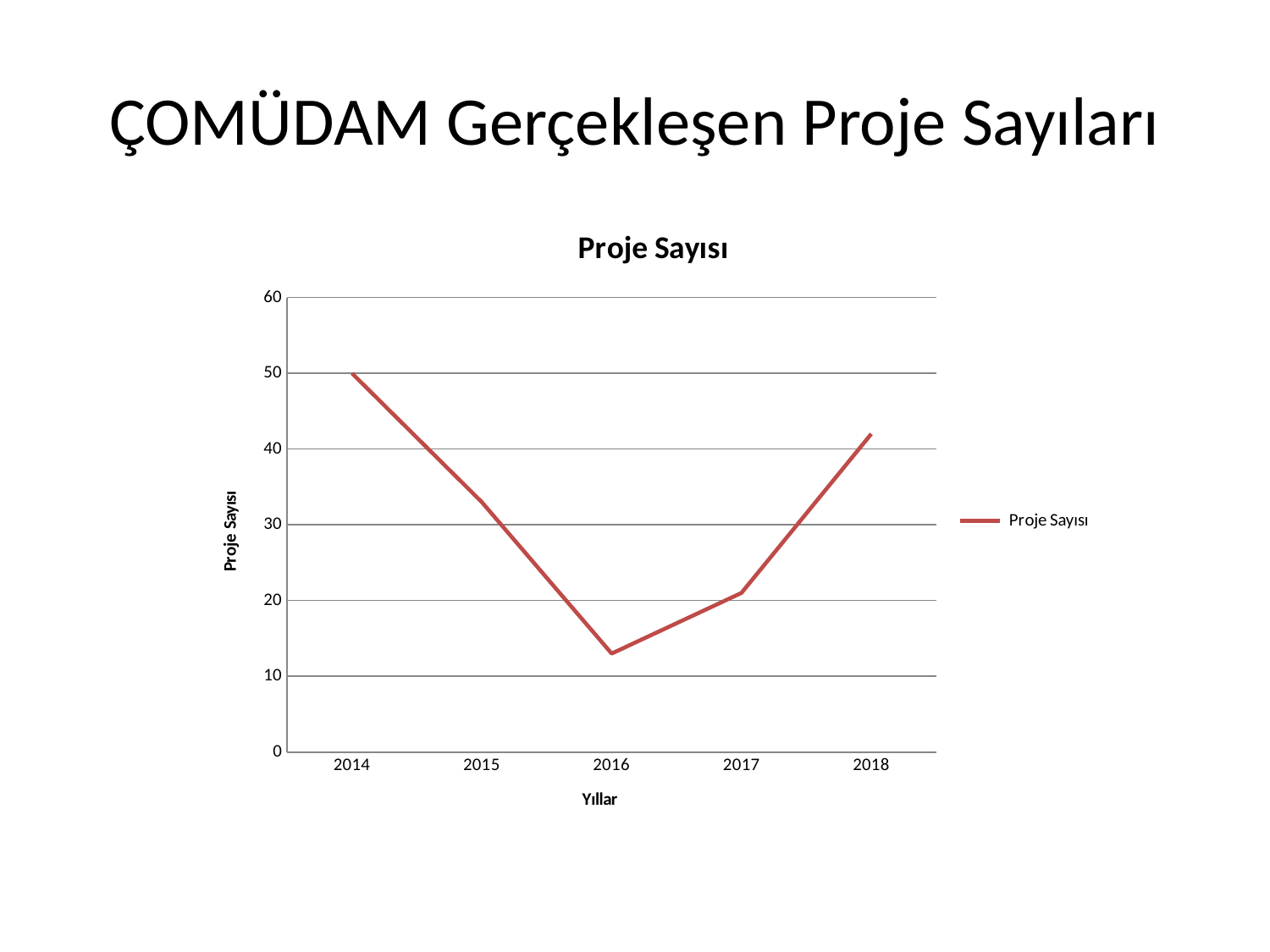
Which year has the highest number of projects? 2014 How many years are plotted on the x axis of the chart? 5 How many series does the legend list? 1 Which year has the lowest number of projects? 2016 Is the value for 2017 greater or less than 30? less Does the number of projects rise or fall from 2014 to 2016? Fall What is the value for 2014? 50 Is the value for 2018 greater or less than 40? greater Which is larger, the value for 2015 or the value for 2017? 2015 What is the label of the x axis? Yıllar What type of chart is shown on the slide? Line chart Is the value for 2016 greater or less than 20? less